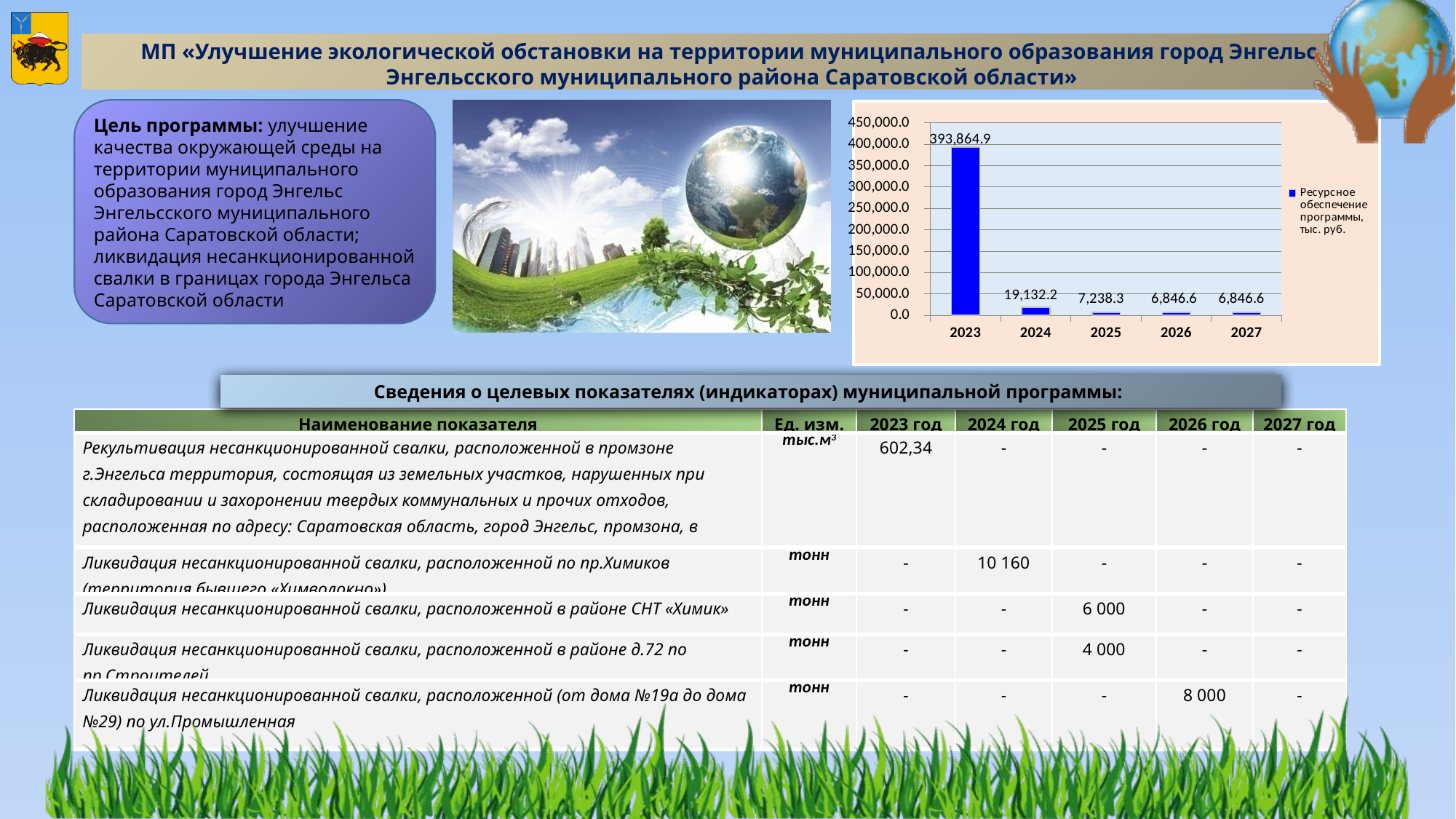
Is the value for 2023 in the chart greater or less than 350,000.0? greater What is the difference between the values for 2024 and 2025 in the chart? 11,893.9 What kind of chart is shown on the slide? bar chart How many years are shown on the x axis of the chart? 5 What is the difference between the values for 2023 and 2024 in the chart? 374,732.7 What is the value for 2025 in the chart? 7,238.3 What is the value for 2023 in the chart? 393,864.9 Which is larger in the chart, the value for 2024 or the value for 2025? 2024 What is the legend entry of the chart? Ресурсное обеспечение программы, тыс. руб. Which year has the highest value in the chart? 2023 What is the value for 2024 in the chart? 19,132.2 What is the value for 2026 in the chart? 6,846.6